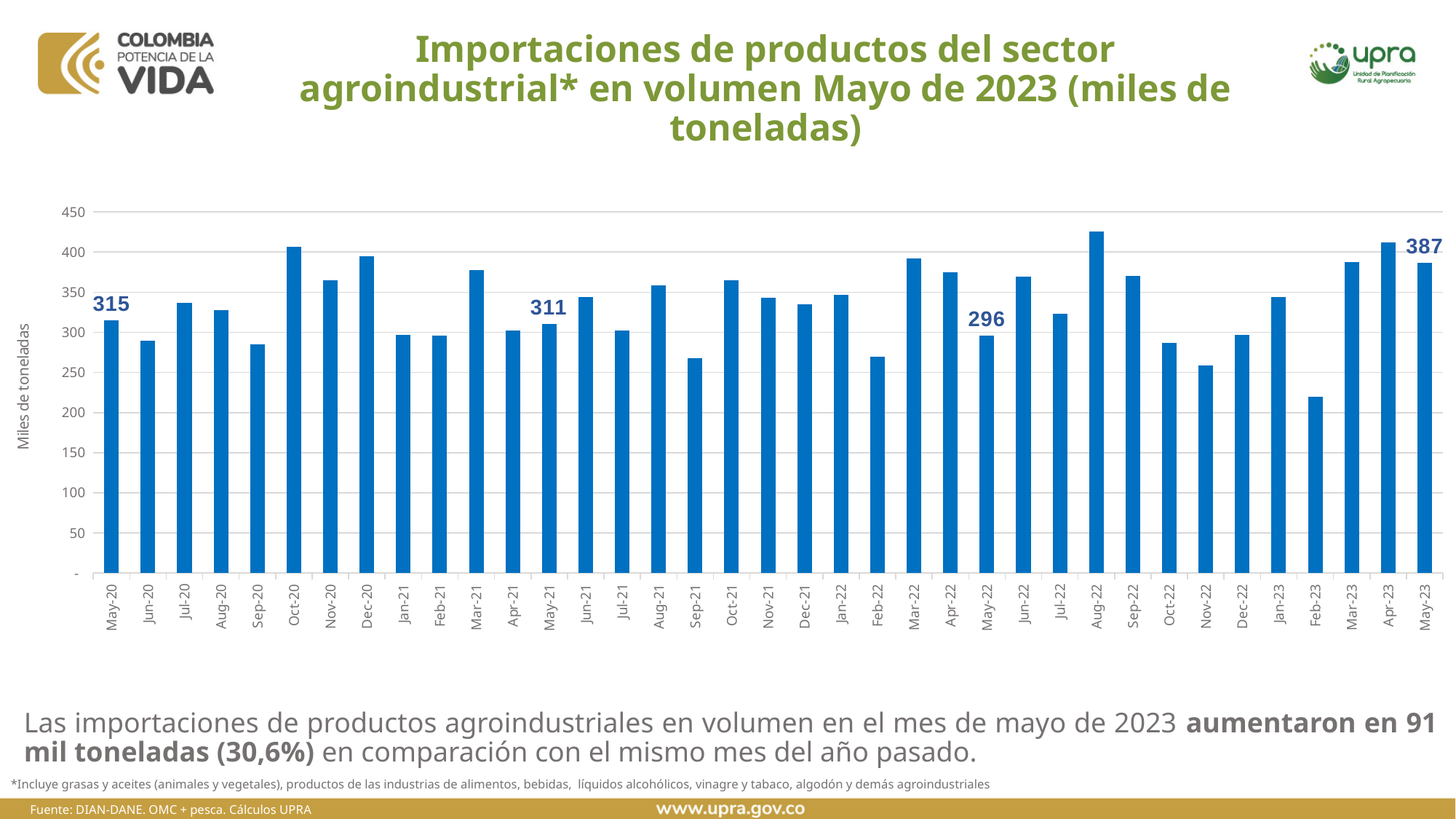
Which is larger, the value for May-20 or the value for May-23? May-23 Which month has the lowest bar? Feb-23 What is the difference between the values for May-23 and May-22? 91 What is the value for May-23? 387 What is the value for May-21? 311 Is the value for Feb-23 greater or less than 250? less How many months are plotted on the chart? 37 Is the value for Aug-22 greater or less than 400? greater What is the value for May-22? 296 Which month has the highest bar? Aug-22 What kind of chart is shown on the slide? bar chart What is the value for May-20? 315